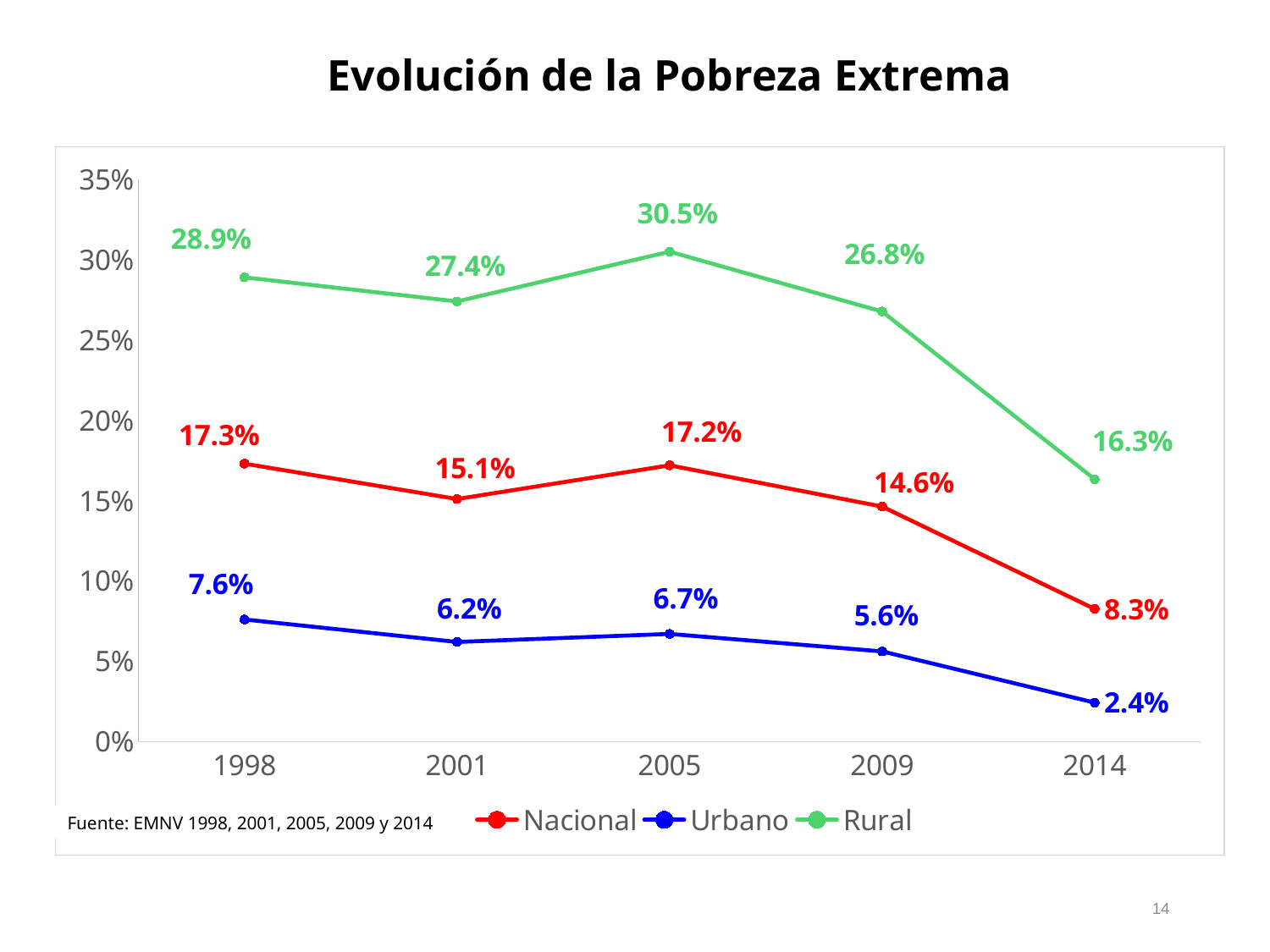
What is the Nacional value in 2001? 15.1% What is the title of the chart? Evolución de la Pobreza Extrema How many series does the legend list? 3 Does the Urbano series rise or fall between 2009 and 2014? fall What is the Rural value in 2005? 30.5% In which year is the Rural series highest? 2005 What kind of chart is shown on the slide? line chart What is the difference between the Rural values in 2009 and 2014? 10.5% How many years are shown on the x axis? 5 Which is larger, the Nacional value in 1998 or the Nacional value in 2005? 1998 What is the Urbano value in 2014? 2.4% In which year is the Nacional series lowest? 2014